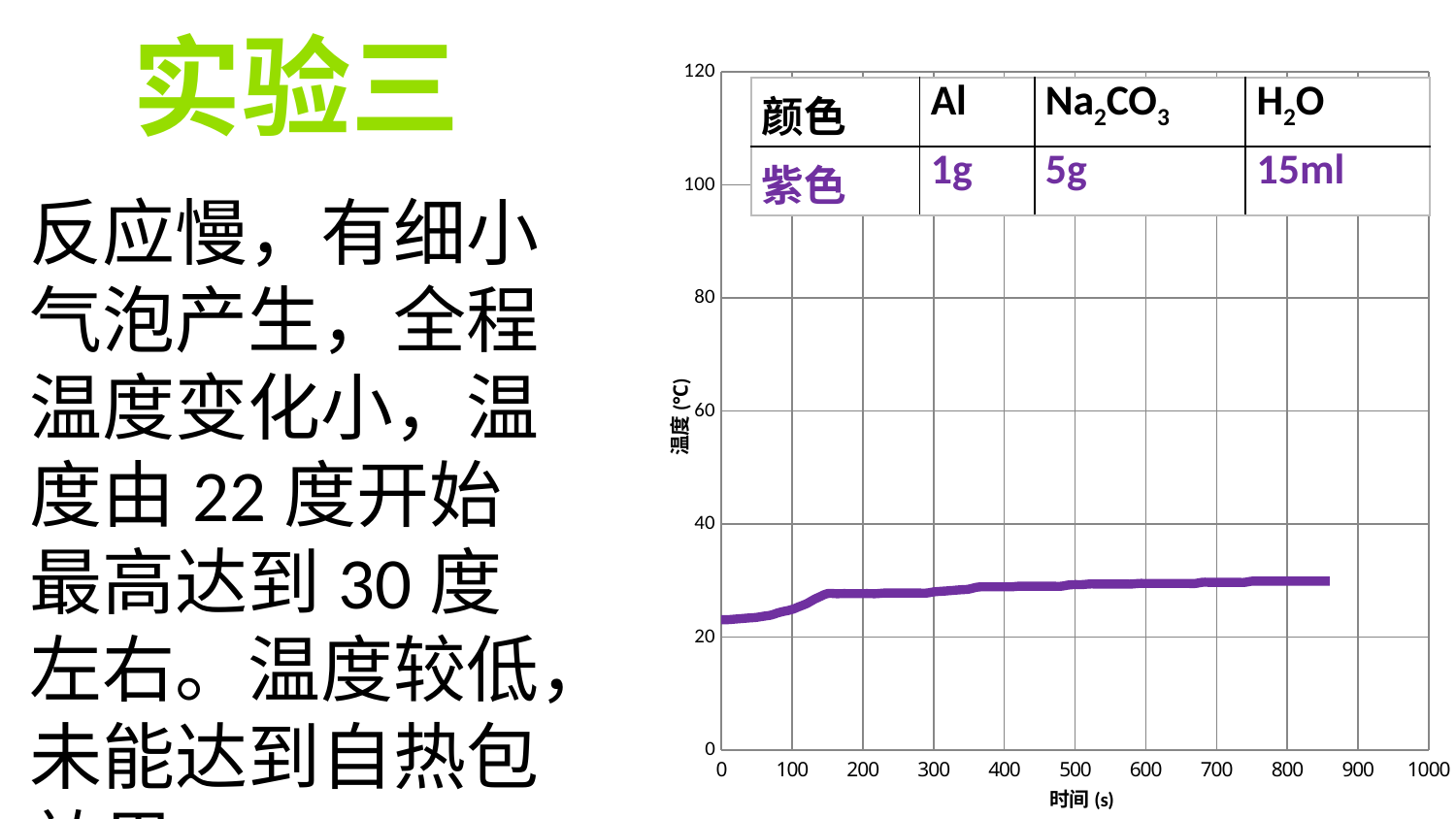
What kind of chart is shown on the slide? line chart Is the highest temperature plotted on the chart greater or less than 60? less Do the plotted temperature values rise or fall as time increases along the x axis? rise Is the temperature value at time 0 s greater or less than 20? greater What is the label of the vertical axis of the chart? 温度 (°C) Is the temperature value at time 500 s greater or less than 40? less What is the label of the horizontal axis of the chart? 时间 (s) What is the highest tick value shown on the vertical axis? 120 What is the highest tick value shown on the horizontal axis? 1000